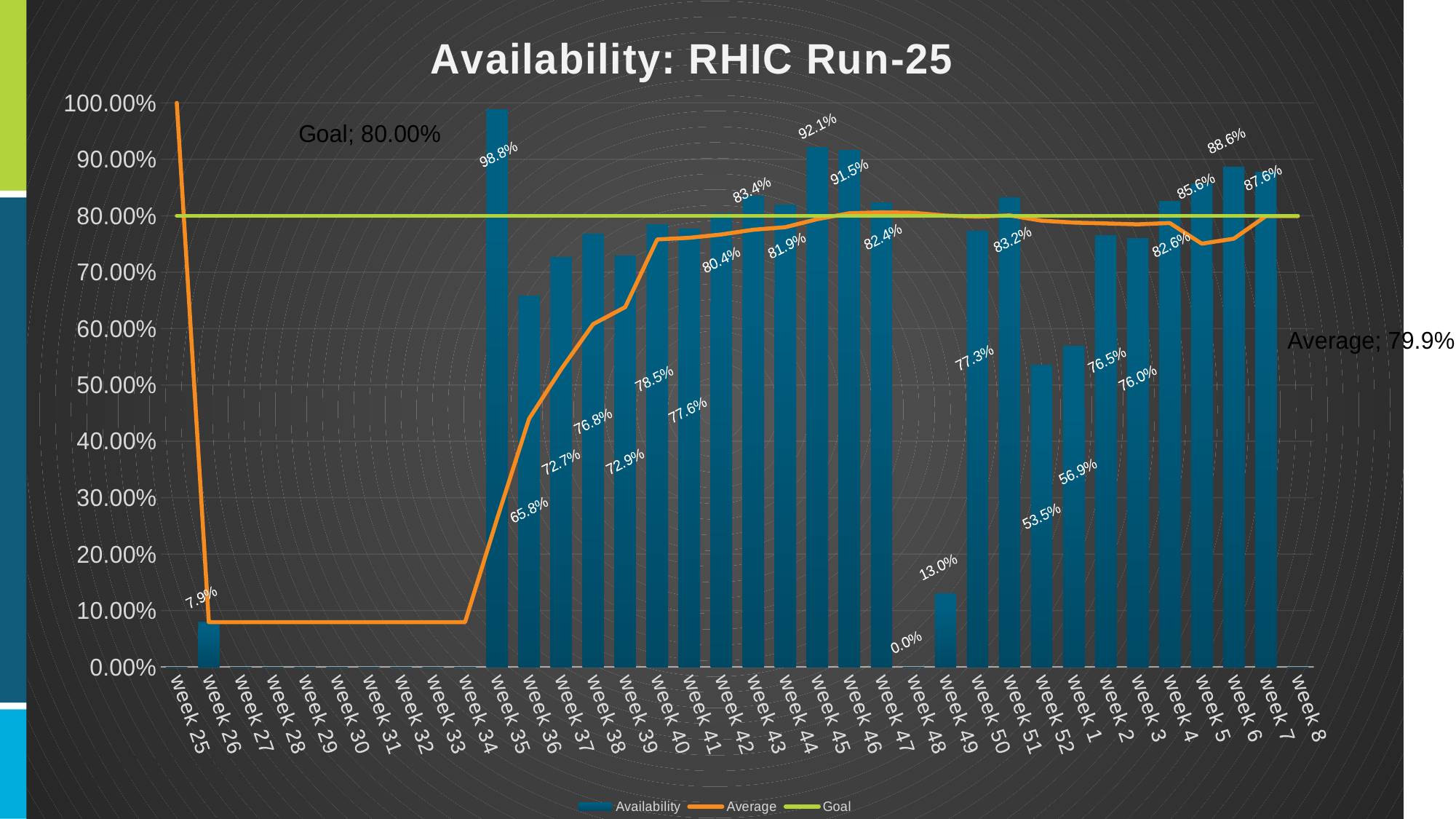
What is the availability for week 48? 0.0% What kind of chart is shown on the slide? combination bar and line chart Is the availability for week 52 greater or less than 60.00%? less Which has the higher availability, week 6 or week 7? week 6 How many weeks are shown along the x axis? 36 What is the availability for week 35? 98.8% How many series does the legend list? 3 What is the availability for week 26? 7.9% What is the availability for week 45? 92.1% What is the difference between the availability for week 45 and week 46? 0.6% Which week has the highest availability? week 35 What goal value is shown on the chart? 80.00%